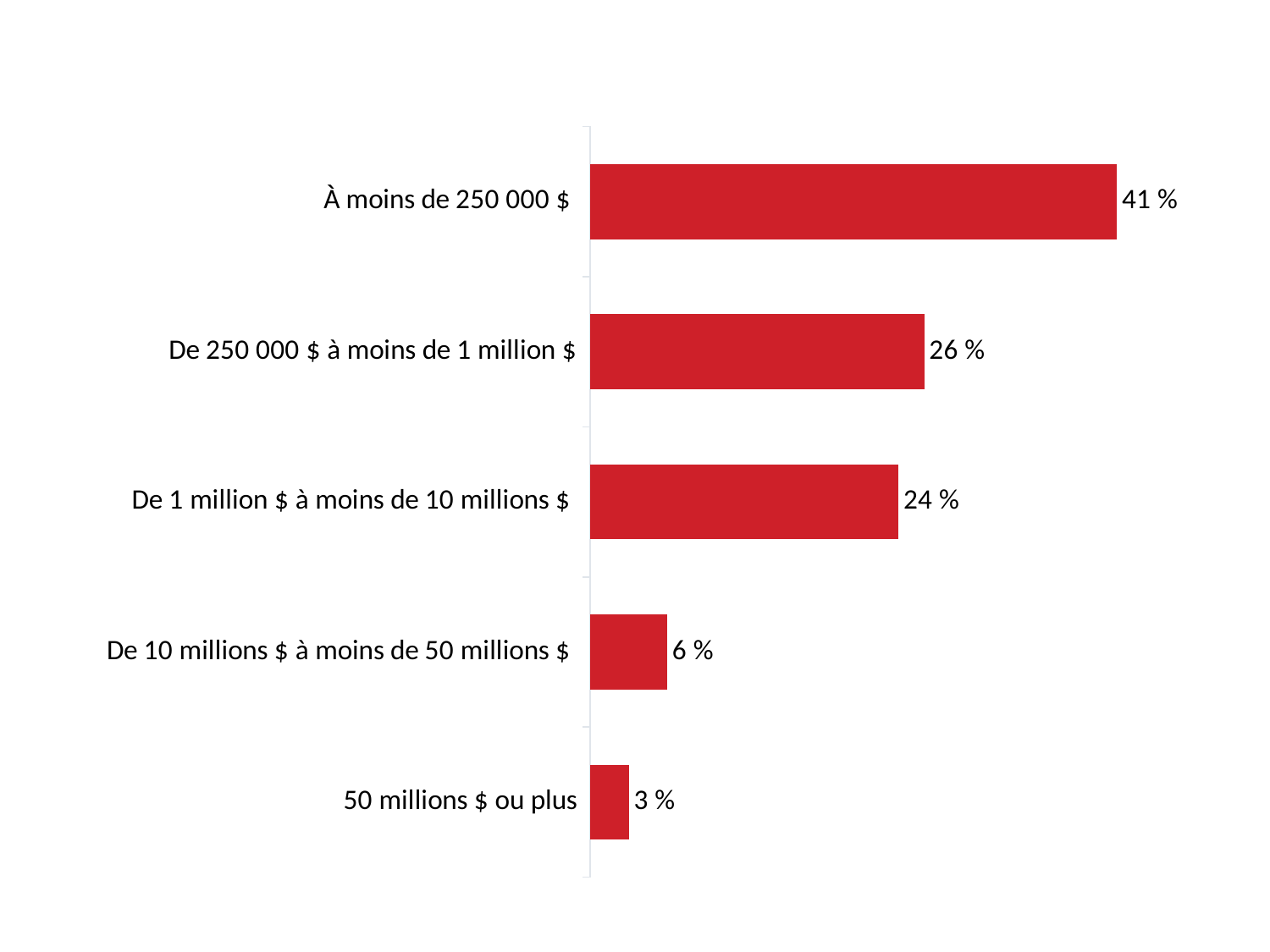
Which category has the lowest value? 50 millions $ ou plus Which is larger, the value for "De 250 000 $ à moins de 1 million $" or the value for "De 1 million $ à moins de 10 millions $"? De 250 000 $ à moins de 1 million $ What is the difference between the values for "À moins de 250 000 $" and "De 250 000 $ à moins de 1 million $"? 15 % How many categories are shown in the chart? 5 What is the value for "De 250 000 $ à moins de 1 million $"? 26 % What kind of chart is shown on the slide? Bar chart What is the value for "De 10 millions $ à moins de 50 millions $"? 6 % What is the value for "De 1 million $ à moins de 10 millions $"? 24 % What is the difference between the values for "De 10 millions $ à moins de 50 millions $" and "50 millions $ ou plus"? 3 % What is the value for "50 millions $ ou plus"? 3 % What is the value for "À moins de 250 000 $"? 41 % Which category has the highest value? À moins de 250 000 $